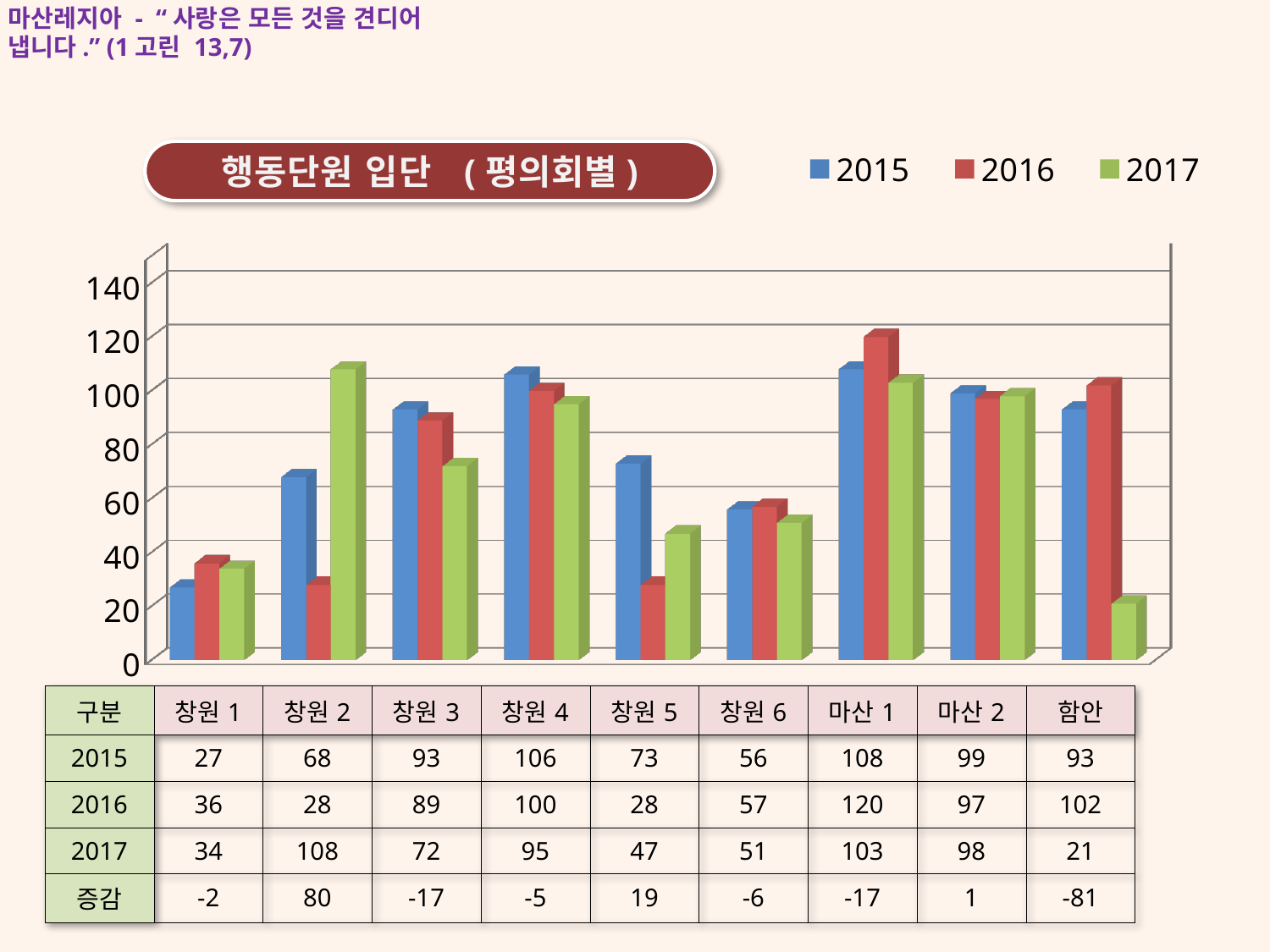
What is the title of the chart? 행동단원 입단 (평의회별) What is the 2017 value for 함안? 21 What is the 2015 value for 창원 4? 106 How many categories are shown on the x axis of the chart? 9 Is the 2016 value for 마산 1 greater or less than 100? greater What is the difference between the 2017 and 2015 values for 창원 2? 40 Which category has the highest 2016 value? 마산 1 What is the 2016 value for 마산 1? 120 Which category has the lowest 2017 value? 함안 How many series does the legend list? 3 Which is larger for 창원 5: the 2015 value or the 2016 value? 2015 What type of chart is shown on the slide? bar chart